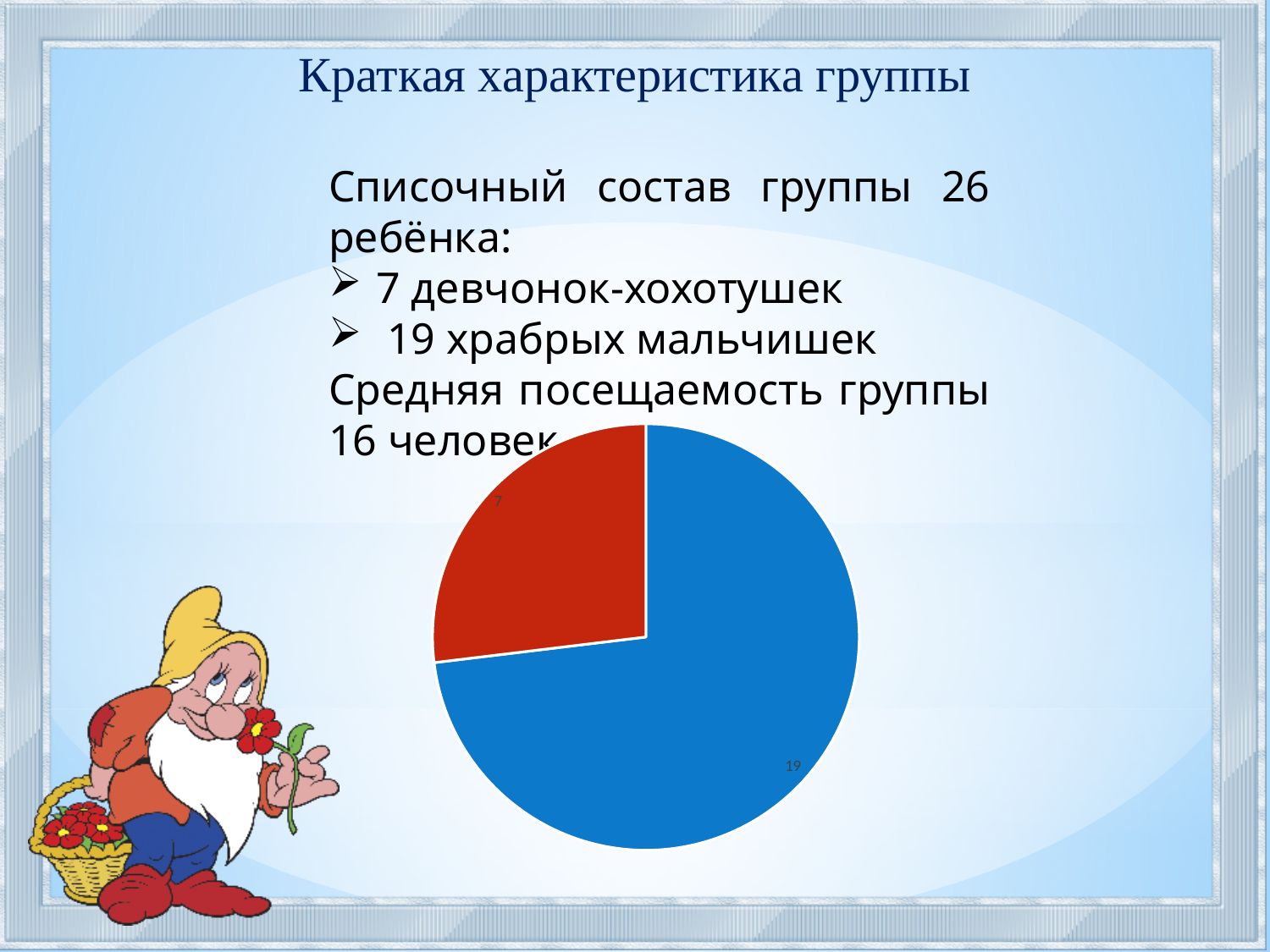
Which is larger in the pie chart, the blue slice or the red slice? the blue slice What is the total of the two values shown in the pie chart? 26 Does the pie chart display a legend? No What kind of chart is shown on the slide? pie chart Is the value of the blue slice greater or less than 10? greater Which slice of the pie chart is the largest? the blue slice (19) What value is printed on the blue slice of the pie chart? 19 What colours are the two slices of the pie chart? blue and red How many slices does the pie chart have? 2 Which slice of the pie chart is the smallest? the red slice (7) What value is printed on the red slice of the pie chart? 7 What is the difference between the values of the blue slice and the red slice in the pie chart? 12